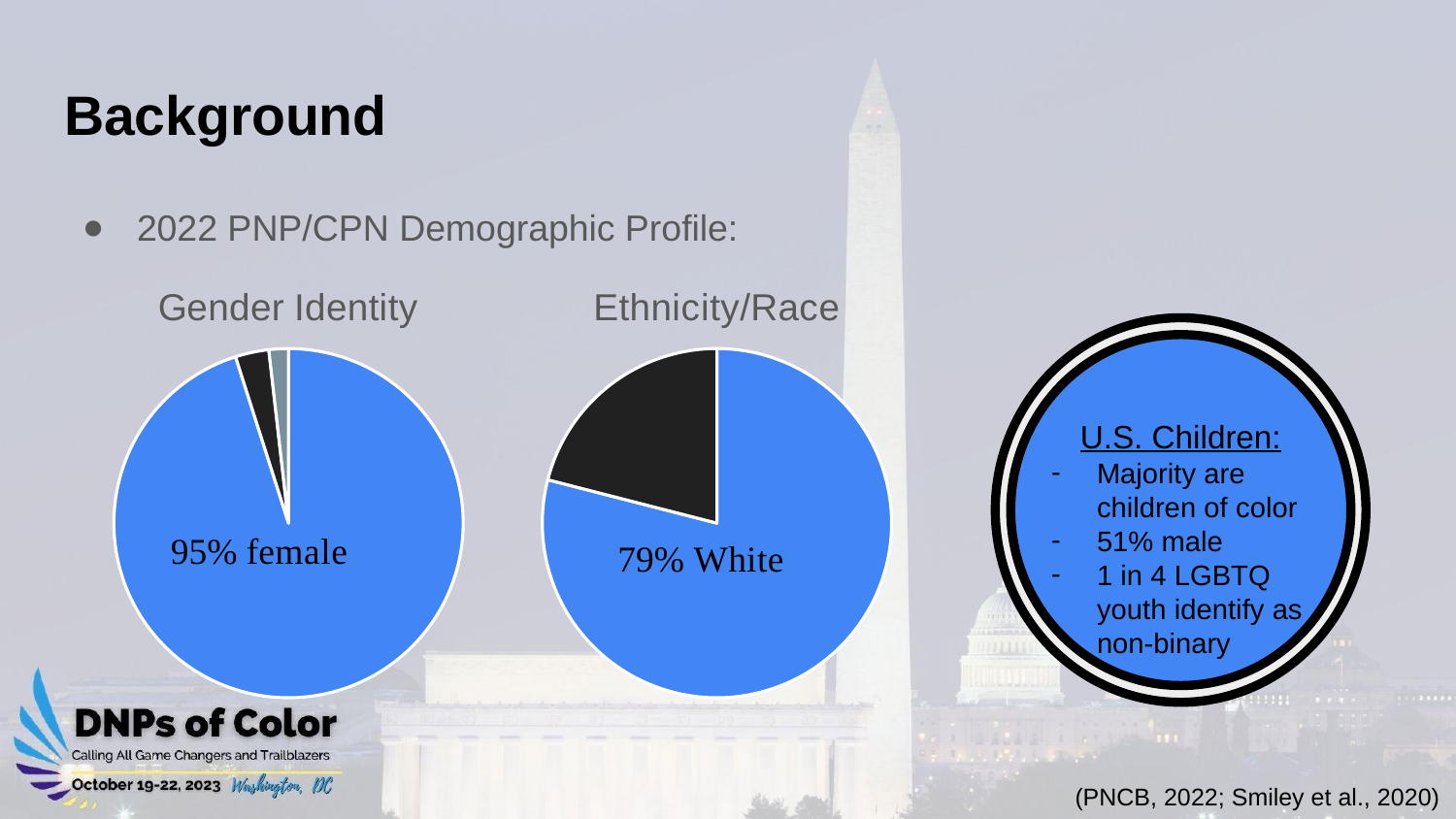
In the Ethnicity/Race chart, is the White share greater or less than 50%? greater How many slices does the Gender Identity pie chart have? 3 In the Ethnicity/Race chart, what share of the pie does the White slice take? 79% What is the title of the pie chart on the left? Gender Identity In the Gender Identity chart, what percentage of PNP/CPNs are female? 95% What kind of chart is the Gender Identity chart? Pie chart Which labelled slice is larger: the female slice in the Gender Identity chart or the White slice in the Ethnicity/Race chart? The female slice (95%) What is the title of the pie chart in the middle of the slide? Ethnicity/Race In the Ethnicity/Race chart, what percentage of PNP/CPNs are White? 79% What kind of chart is the Ethnicity/Race chart? Pie chart In the Gender Identity chart, what share of the pie does the female slice take? 95% How many slices does the Ethnicity/Race pie chart have? 2